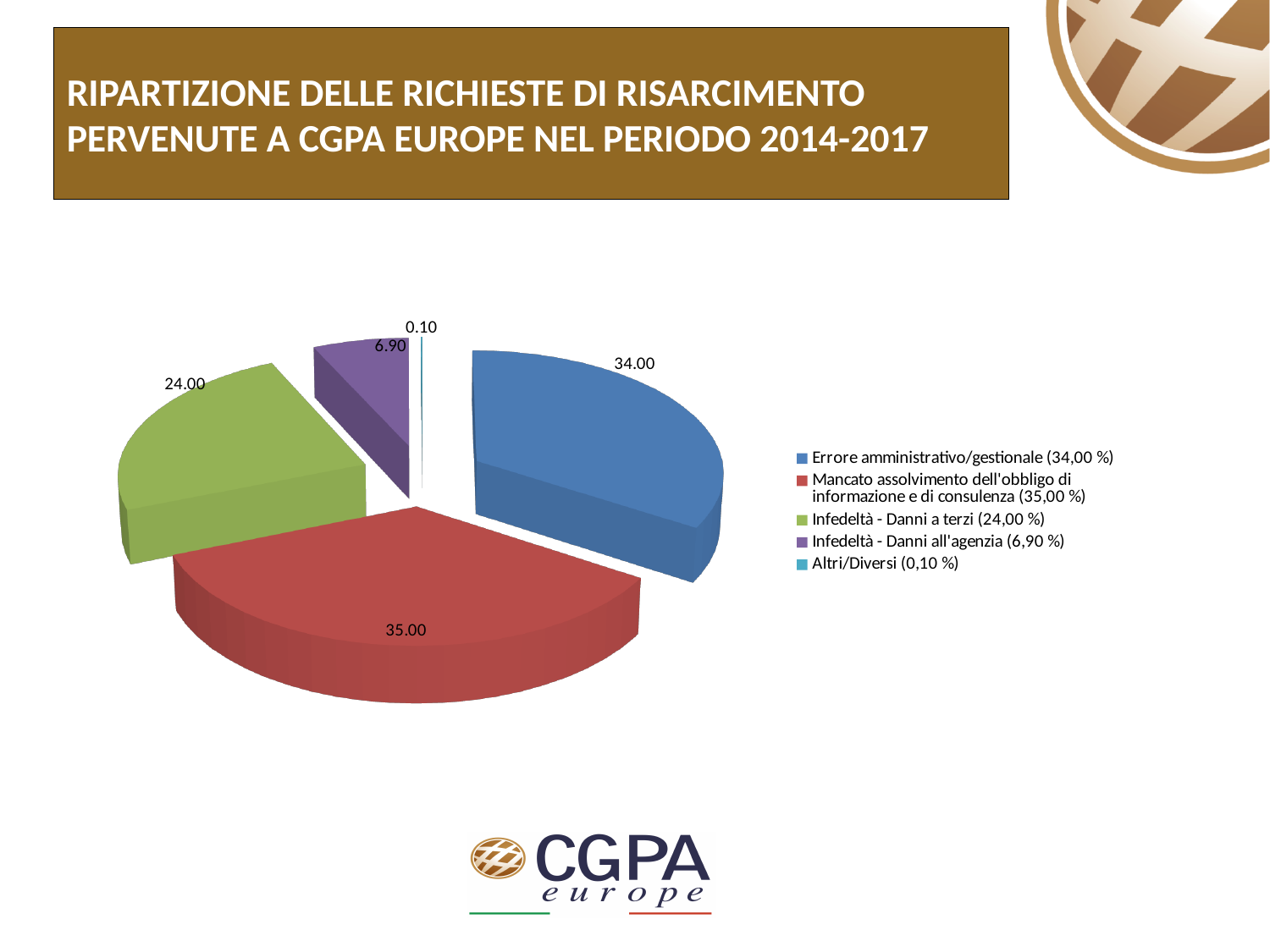
What is the value shown for Infedeltà - Danni a terzi? 24.00 What is the difference between the values for Errore amministrativo/gestionale and Infedeltà - Danni a terzi? 10.00 What is the value shown for Altri/Diversi? 0.10 What is the value shown for Infedeltà - Danni all'agenzia? 6.90 Which is larger: the value for Infedeltà - Danni a terzi or the value for Infedeltà - Danni all'agenzia? Infedeltà - Danni a terzi What share of the pie does Mancato assolvimento dell'obbligo di informazione e di consulenza represent, according to the legend? 35,00 % How many categories does the pie chart show? 5 Which category has the smallest slice of the pie? Altri/Diversi What is the value shown for Errore amministrativo/gestionale? 34.00 Which category has the largest slice of the pie? Mancato assolvimento dell'obbligo di informazione e di consulenza What kind of chart is shown on the slide? pie chart What colour is the slice for Infedeltà - Danni a terzi? green